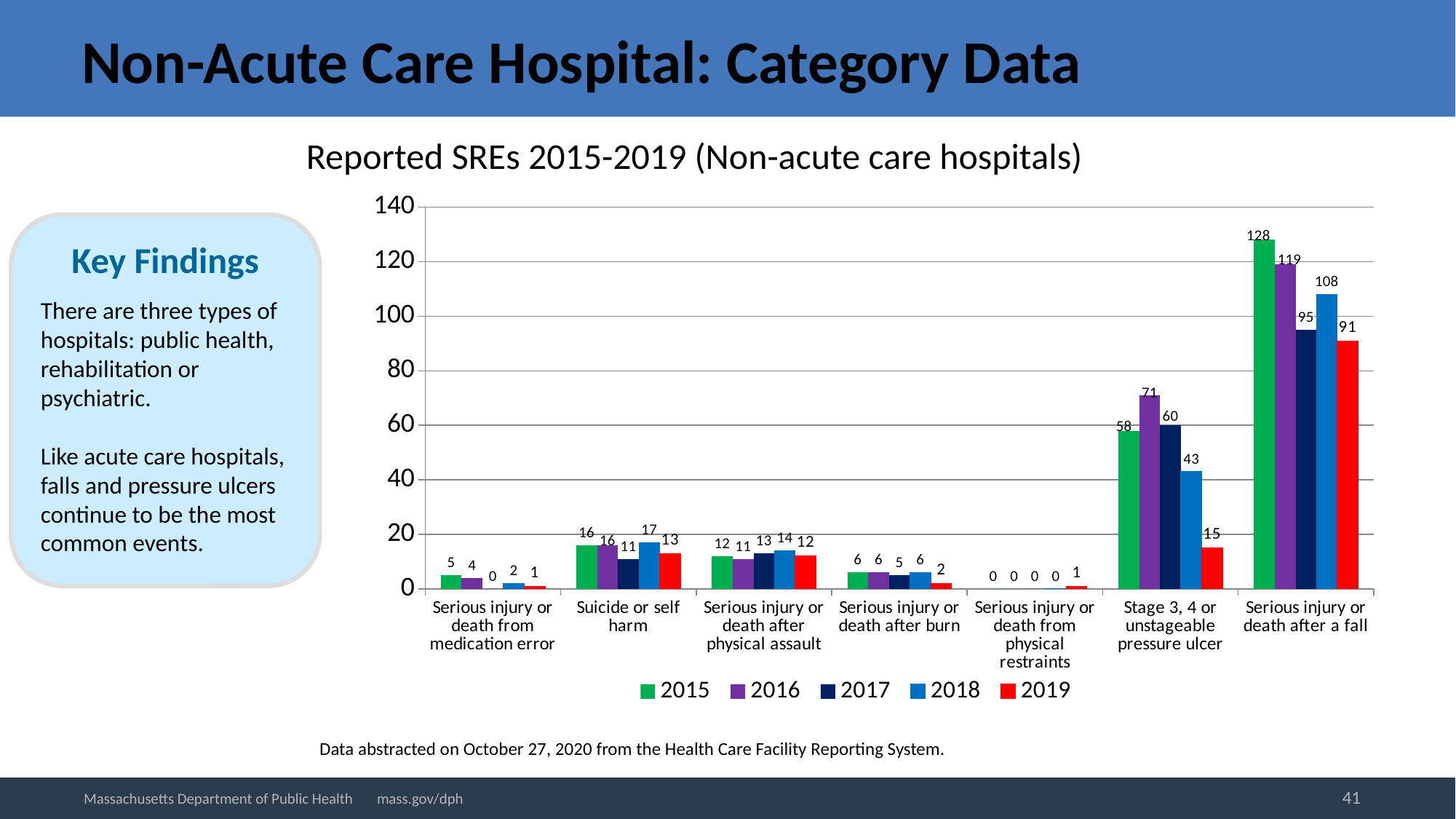
Is the 2018 value for 'Serious injury or death after a fall' greater or less than 100? greater What is the title of the chart? Reported SREs 2015-2019 (Non-acute care hospitals) How many series does the legend list? 5 What is the difference between the 2015 and 2019 values for 'Serious injury or death after a fall'? 37 Which year has the highest value in the 'Stage 3, 4 or unstageable pressure ulcer' category? 2016 What is the value for 2019 in the 'Stage 3, 4 or unstageable pressure ulcer' category? 15 What is the value for 2018 in the 'Suicide or self harm' category? 17 What kind of chart is shown on the slide? Bar chart How many categories are shown on the x axis? 7 Which year has the lowest value in the 'Serious injury or death after a fall' category? 2019 Which is larger in the 'Serious injury or death after physical assault' category: the 2018 value or the 2016 value? 2018 What is the value for 2015 in the 'Serious injury or death after a fall' category? 128